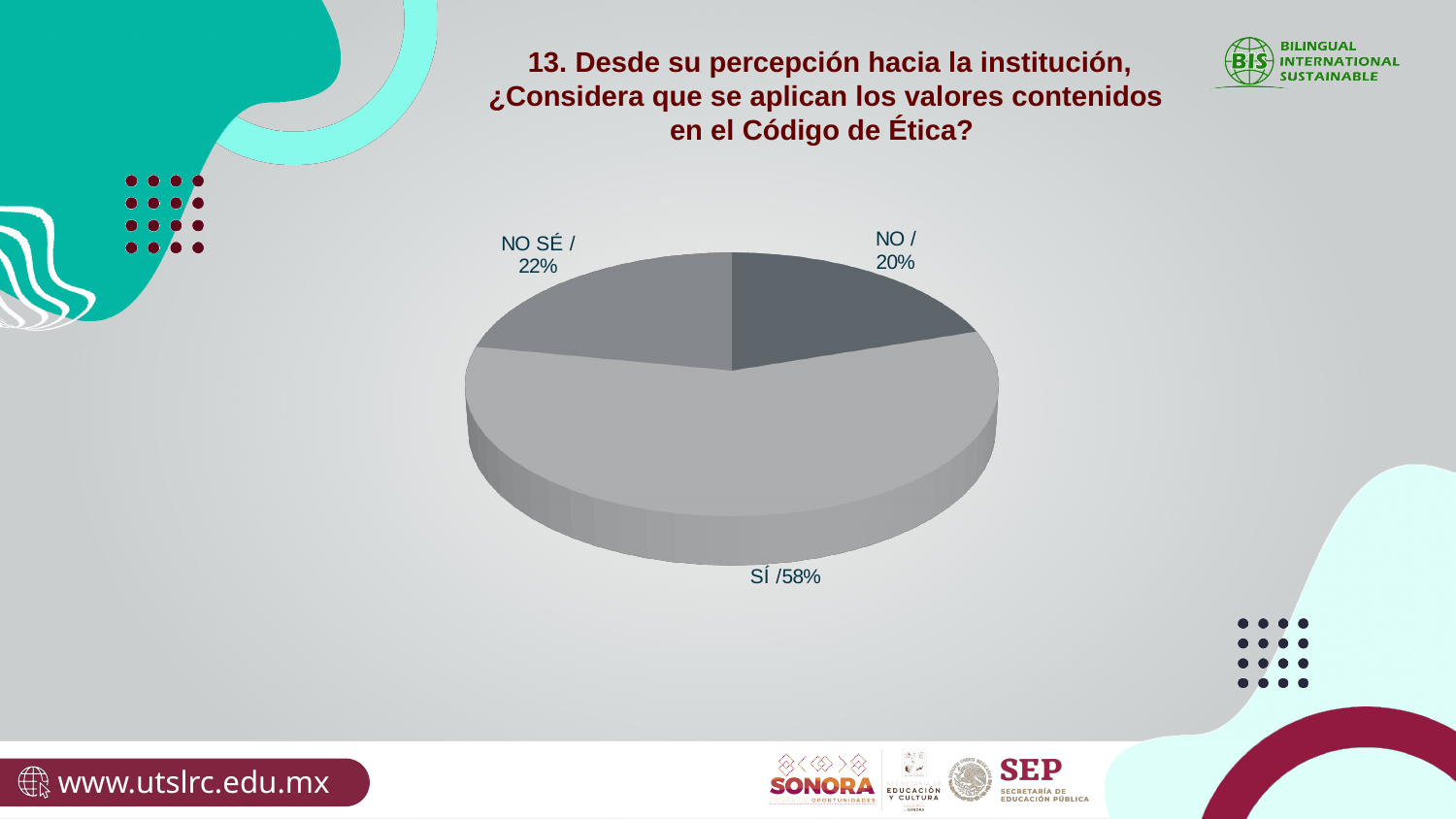
Which category has the largest slice of the pie? SÍ What share of the pie does the NO SÉ slice represent? 22% How many slices does the pie chart have? 3 What is the title of the chart on the slide? 13. Desde su percepción hacia la institución, ¿Considera que se aplican los valores contenidos en el Código de Ética? Which is larger, the SÍ slice or the NO slice? SÍ What is the difference in percentage points between the NO SÉ slice and the NO slice? 2 What share of the pie does the NO slice represent? 20% What is the difference in percentage points between the SÍ slice and the NO SÉ slice? 36 What kind of chart is shown on the slide? Pie chart Which is larger, the NO SÉ slice or the NO slice? NO SÉ Which category has the smallest slice of the pie? NO What share of the pie does the SÍ slice represent? 58%